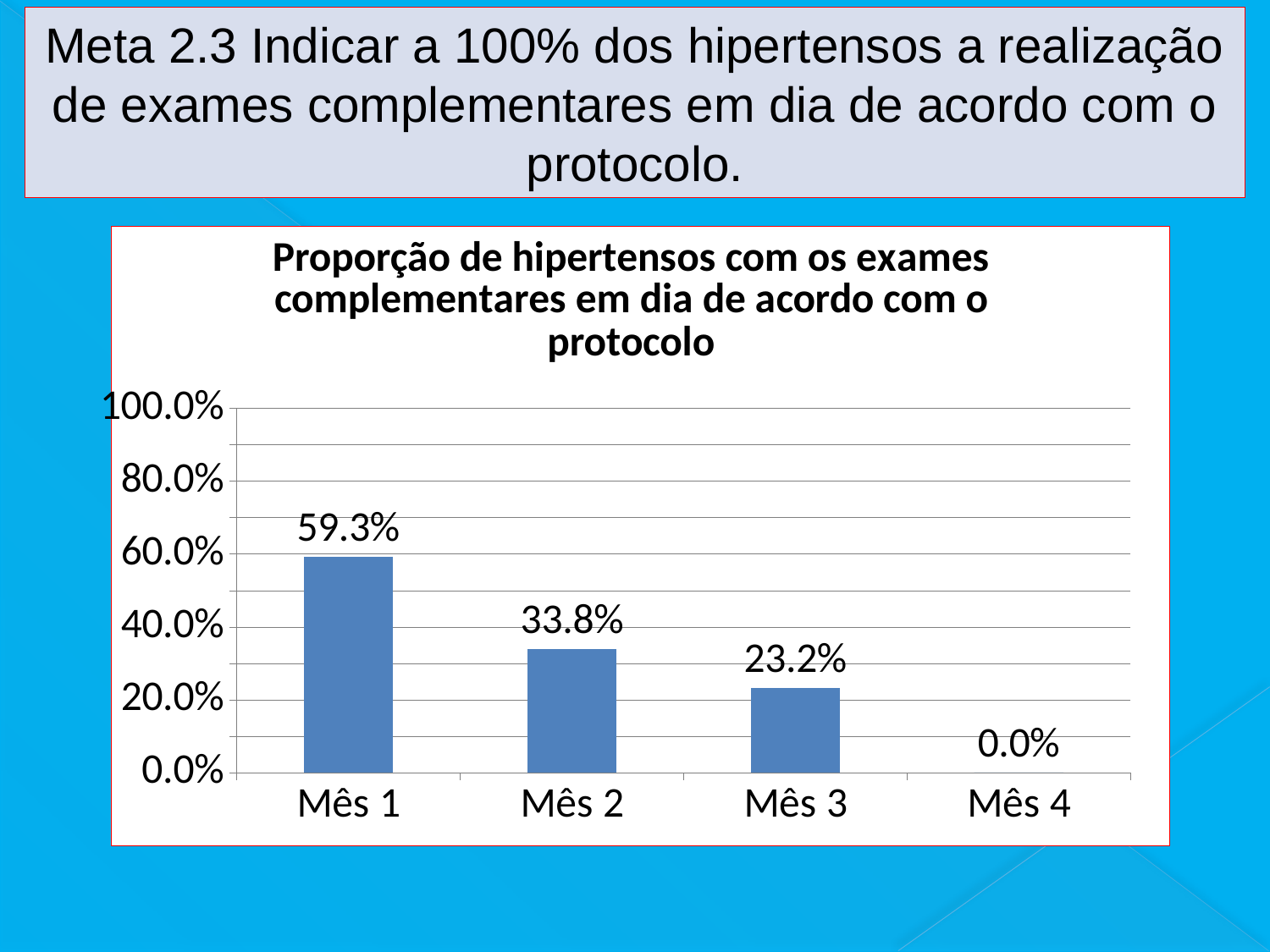
What is the value for Mês 4? 0.0% What is the value for Mês 3? 23.2% What is the value for Mês 1? 59.3% Which month has the highest value? Mês 1 Is the value for Mês 1 greater or less than 40.0%? greater How many months are shown on the x axis? 4 What is the value for Mês 2? 33.8% Which month has the lowest value? Mês 4 Do the values rise or fall from Mês 1 to Mês 4? fall What kind of chart is shown on the slide? bar chart What is the difference between the values for Mês 1 and Mês 2? 25.5% Which is larger, the value for Mês 2 or the value for Mês 3? Mês 2